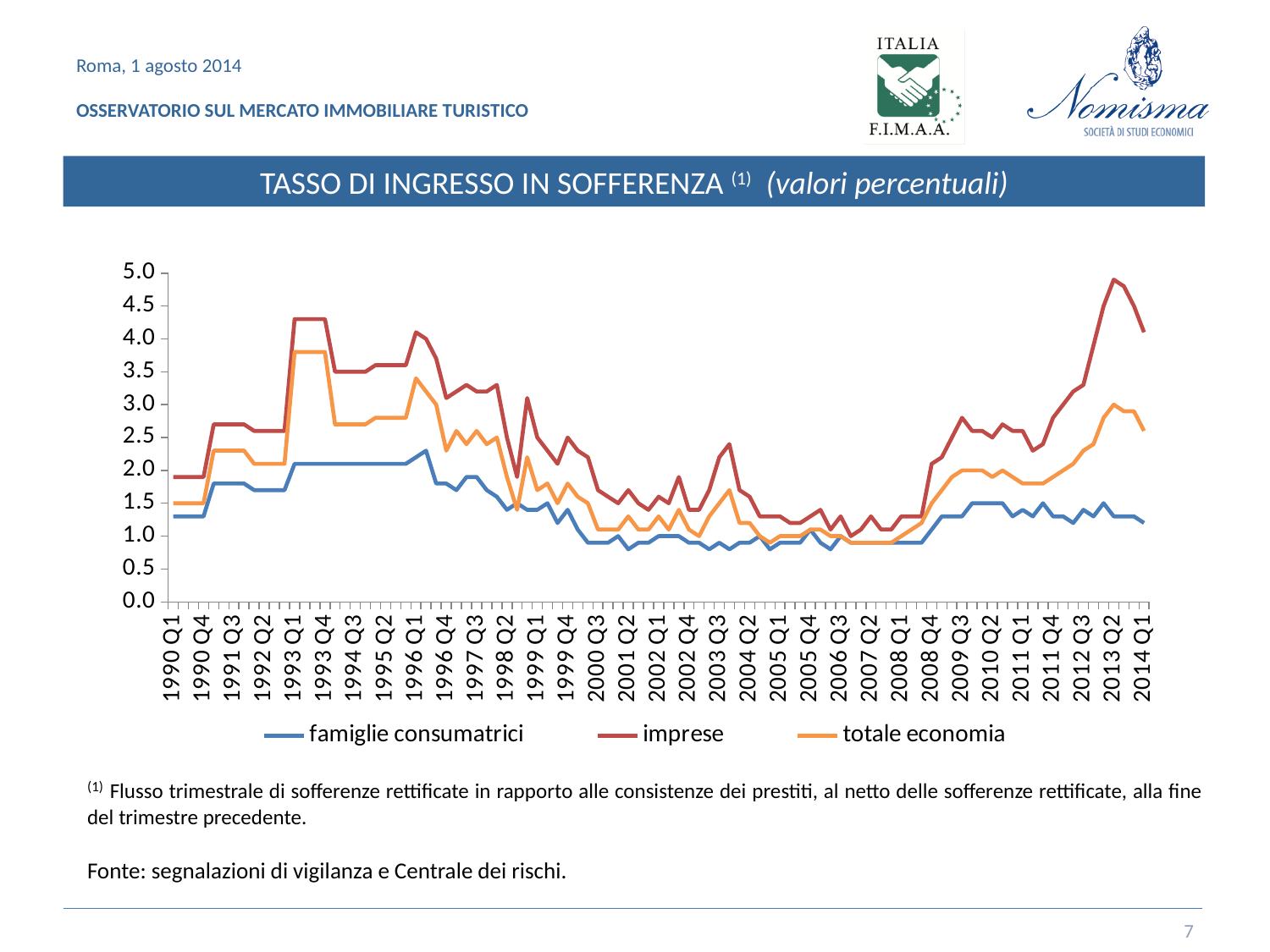
What colour is the line for imprese? red Is the value for totale economia at 1993 Q1 greater or less than 3.5? greater What kind of chart is shown on the slide? line chart What are the three series named in the legend? famiglie consumatrici, imprese, totale economia Is the value for imprese at 1993 Q1 greater or less than 4.0? greater Is the value for famiglie consumatrici at 1990 Q1 greater or less than 1.5? less Which series has the lowest value at 1993 Q1? famiglie consumatrici Which series has the highest value at 2014 Q1? imprese How many series does the legend list? 3 Does the imprese line rise or fall between 2008 Q1 and 2013 Q2? rise